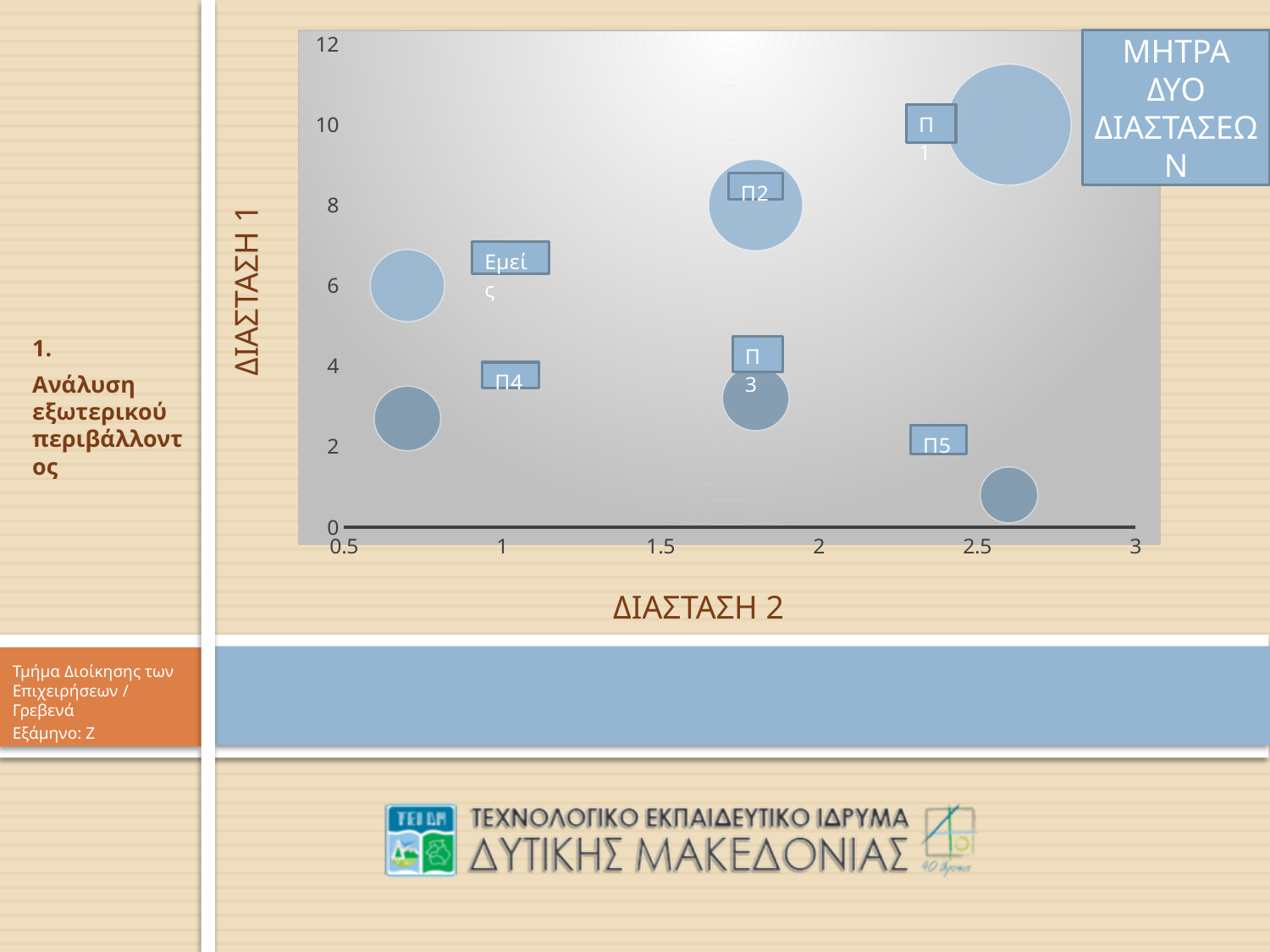
Which bubble has the lowest value on the ΔΙΑΣΤΑΣΗ 1 axis? Π5 What is the label of the vertical axis of the chart? ΔΙΑΣΤΑΣΗ 1 Which has the higher ΔΙΑΣΤΑΣΗ 2 value, Π4 or Π5? Π5 How many labelled bubbles are plotted on the chart? 6 What is the title of the chart? ΜΗΤΡΑ ΔΥΟ ΔΙΑΣΤΑΣΕΩΝ Which has the higher ΔΙΑΣΤΑΣΗ 1 value, Π2 or Π3? Π2 Is the ΔΙΑΣΤΑΣΗ 2 value for Εμείς greater or less than 1? less Is the ΔΙΑΣΤΑΣΗ 1 value for Π5 greater or less than 2? less Is the ΔΙΑΣΤΑΣΗ 1 value for Π2 greater or less than 6? greater Which bubble has the highest value on the ΔΙΑΣΤΑΣΗ 1 axis? Π1 What kind of chart is shown on the slide? Bubble chart